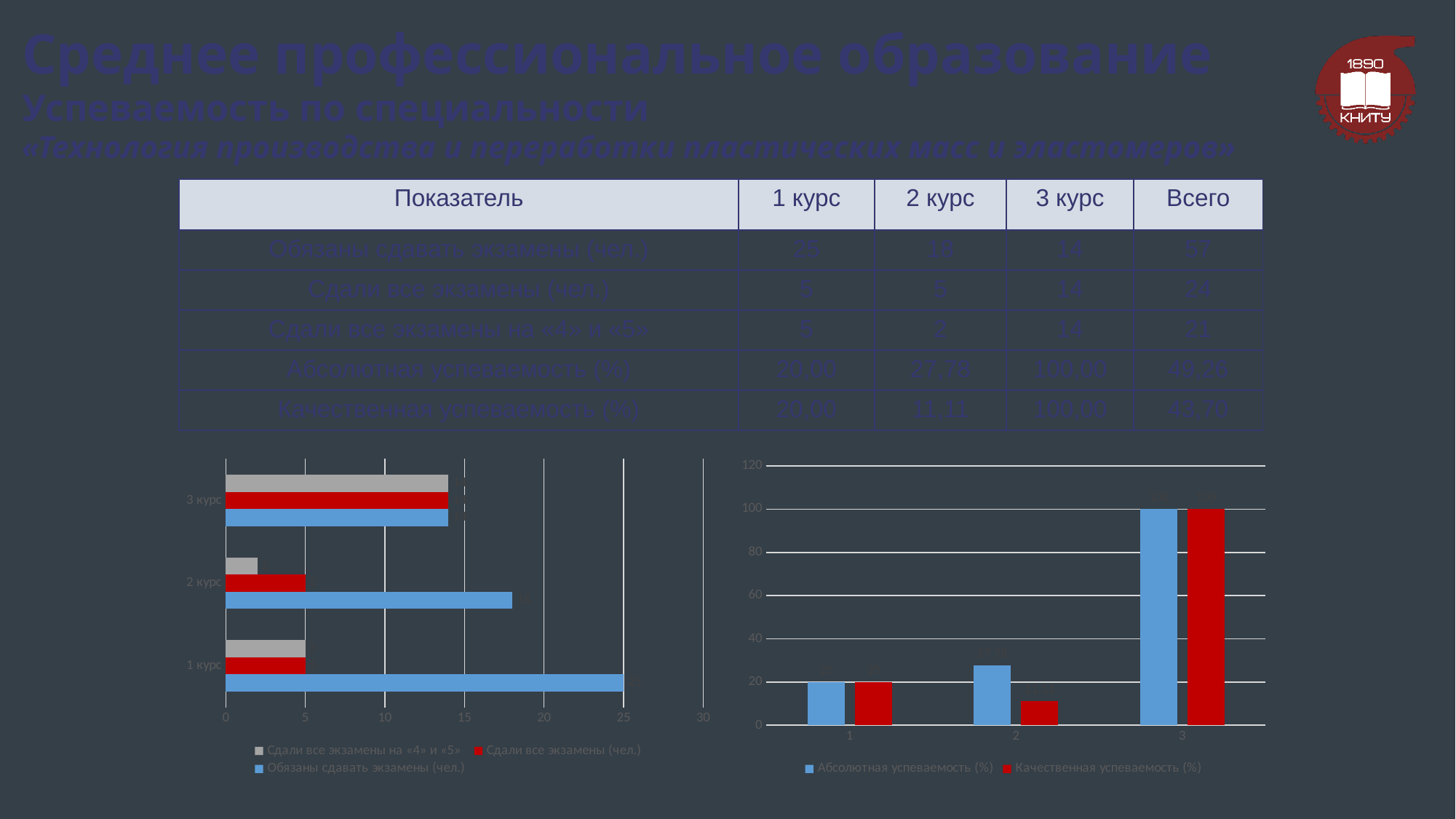
In the right chart, what is the value of Качественная успеваемость (%) for category 1? 20 How many categories are shown on the left chart? 3 In the right chart, what is the value of Абсолютная успеваемость (%) for category 3? 100 In the left chart, which category has the highest value for Обязаны сдавать экзамены (чел.)? 1 курс In the left chart, is the value of Сдали все экзамены на «4» и «5» for 2 курс greater or less than 5? less In the left chart, which is larger for 2 курс: Сдали все экзамены (чел.) or Сдали все экзамены на «4» и «5»? Сдали все экзамены (чел.) In the left chart, is the value of Обязаны сдавать экзамены (чел.) for 2 курс greater or less than 15? greater How many series does the legend of the left chart list? 3 In the left chart, what is the value of Сдали все экзамены (чел.) for 1 курс? 5 In the left chart, what is the value of Обязаны сдавать экзамены (чел.) for 1 курс? 25 In the right chart, is the value of Качественная успеваемость (%) for category 2 greater or less than 20? less What kind of chart is the chart on the left of the slide? bar chart